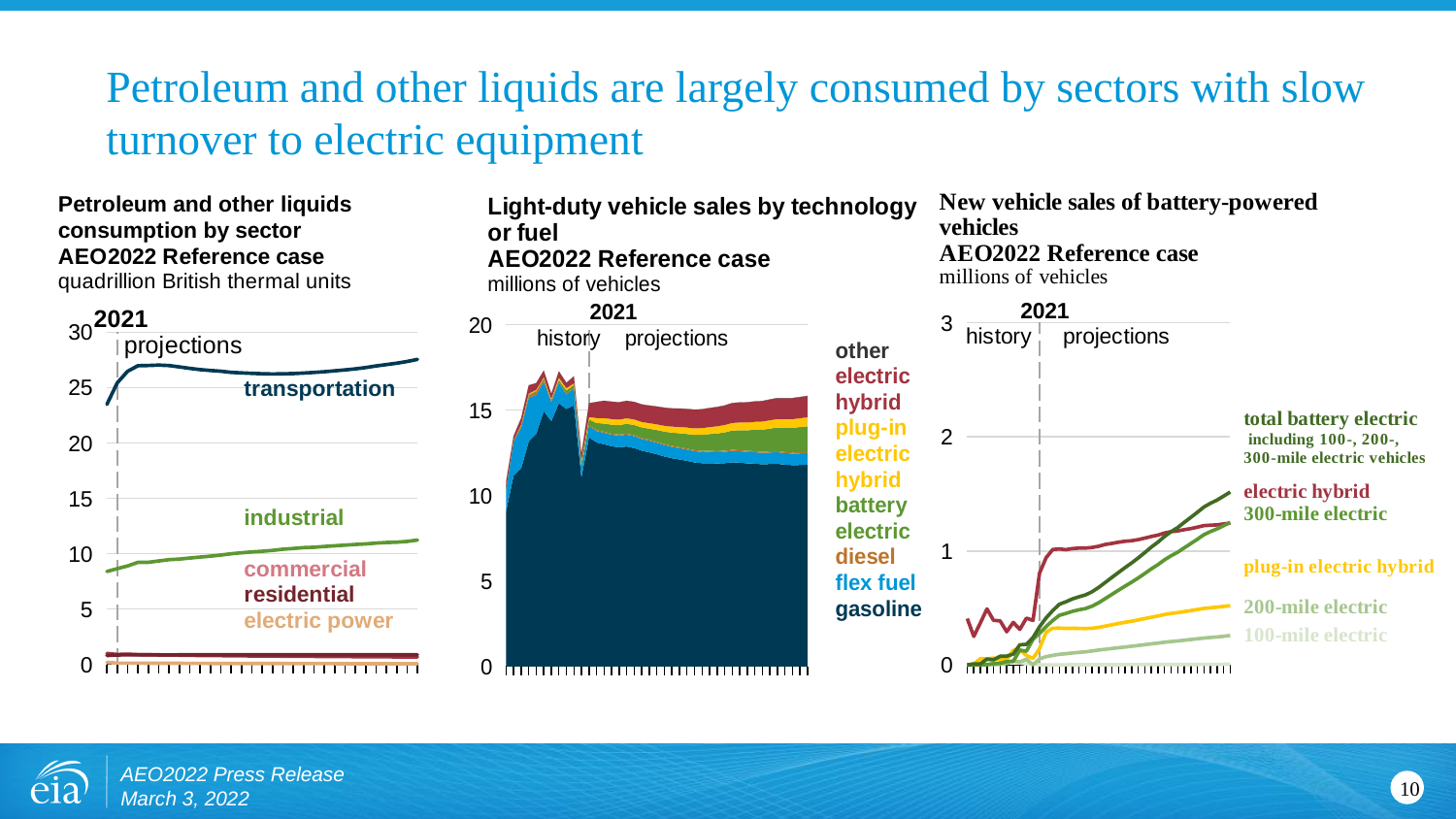
In the 'Petroleum and other liquids consumption by sector' chart, which sector has the highest consumption? transportation In the 'Petroleum and other liquids consumption by sector' chart, is the value for industrial at the end of the projection period greater or less than 15? less In the 'Light-duty vehicle sales by technology or fuel' chart, is total light-duty vehicle sales at the end of the projection period greater or less than 10 million vehicles? greater In the 'New vehicle sales of battery-powered vehicles' chart, which series is highest at the end of the projection period? total battery electric In the 'New vehicle sales of battery-powered vehicles' chart, is the value for plug-in electric hybrid at the end of the projection period greater or less than 1? less In the 'Petroleum and other liquids consumption by sector' chart, does the industrial line rise or fall over the projection period? rise In the 'Light-duty vehicle sales by technology or fuel' chart, which technology or fuel accounts for the largest share of sales? gasoline What kind of chart is the 'Petroleum and other liquids consumption by sector' chart? line chart In the 'Petroleum and other liquids consumption by sector' chart, which is larger at the end of the projections, transportation or industrial? transportation How many technology or fuel categories does the legend of the 'Light-duty vehicle sales by technology or fuel' chart list? 7 What kind of chart is the 'Light-duty vehicle sales by technology or fuel' chart? stacked area chart